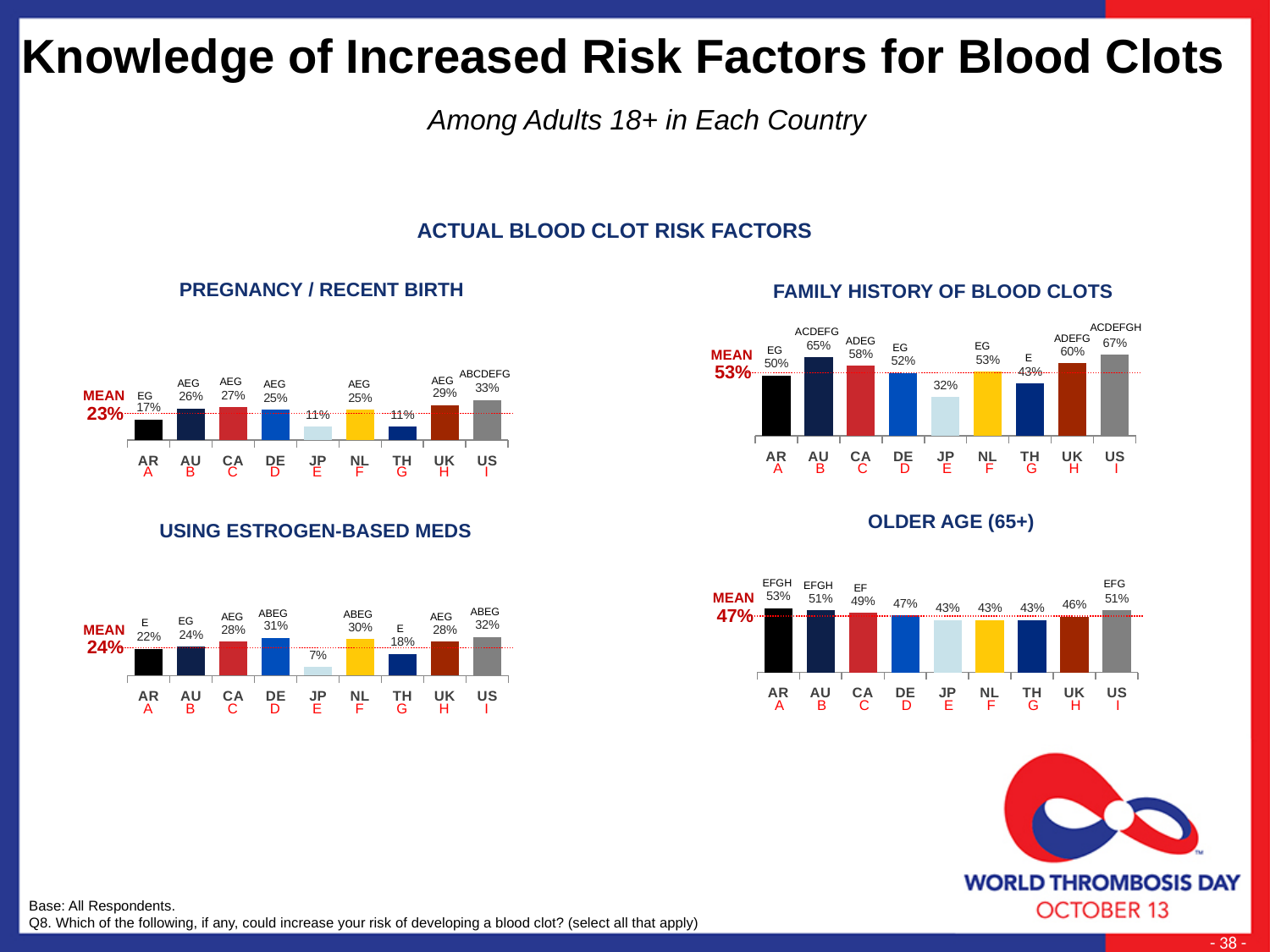
In the OLDER AGE (65+) chart, what is the value for AR? 53% What is the MEAN value shown for the USING ESTROGEN-BASED MEDS chart? 24% In the OLDER AGE (65+) chart, what is the difference between AR and JP? 10% In the USING ESTROGEN-BASED MEDS chart, what is the value for JP? 7% In the FAMILY HISTORY OF BLOOD CLOTS chart, which country has the lowest value? JP How many countries are shown in the OLDER AGE (65+) chart? 9 What type of chart is the FAMILY HISTORY OF BLOOD CLOTS chart? Bar chart In the FAMILY HISTORY OF BLOOD CLOTS chart, what is the value for JP? 32% In the PREGNANCY / RECENT BIRTH chart, which country has the highest value? US In the FAMILY HISTORY OF BLOOD CLOTS chart, what is the difference between US and AR? 17% In the USING ESTROGEN-BASED MEDS chart, which is larger, the value for DE or the value for TH? DE In the PREGNANCY / RECENT BIRTH chart, what is the value for US? 33%